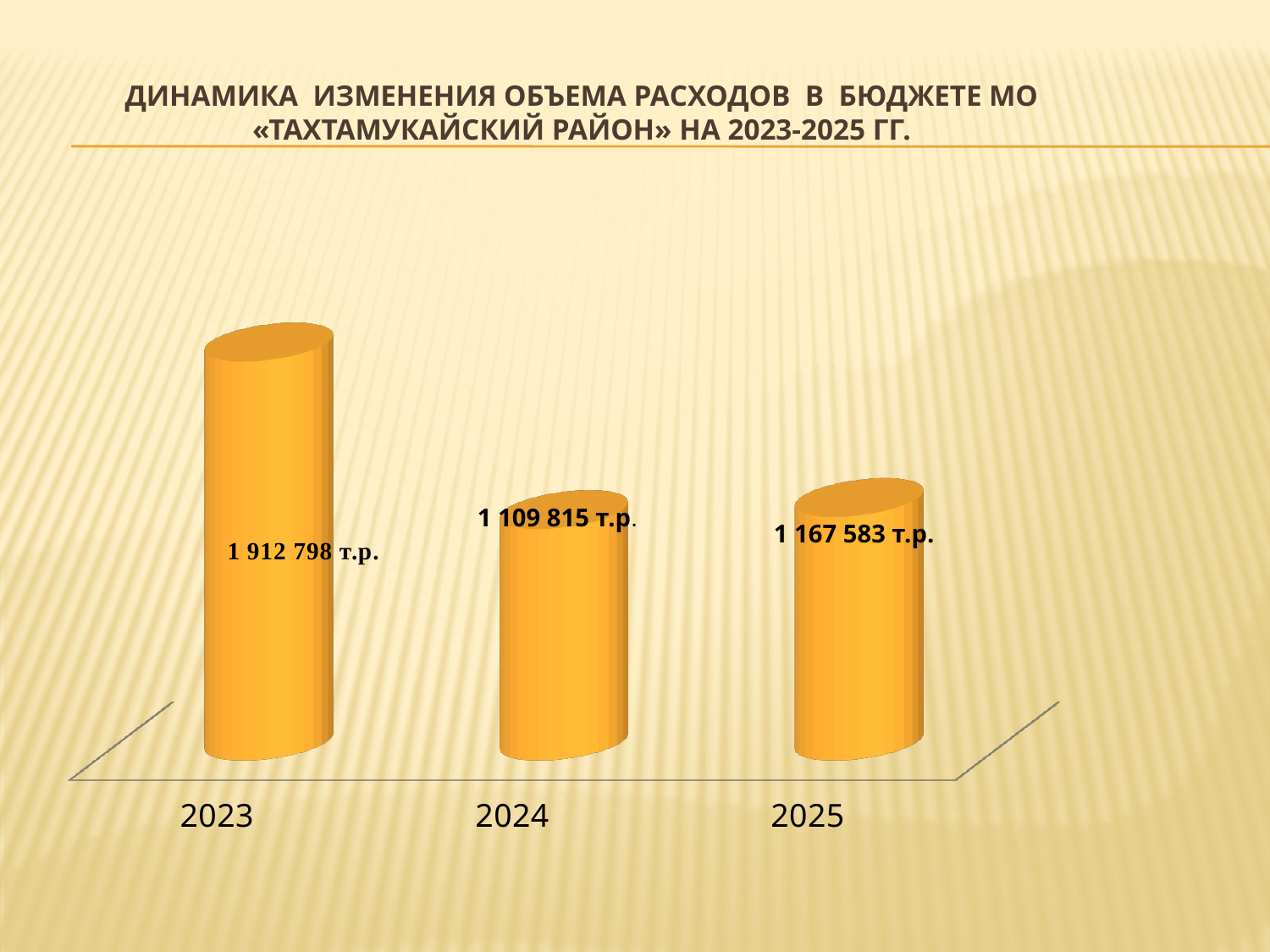
Which year has the highest value? 2023 How many years are shown on the chart? 3 Which year has the lowest value? 2024 What is the value shown for 2023? 1 912 798 т.р. What is the value shown for 2024? 1 109 815 т.р. What kind of chart is shown on the slide? Bar chart What is the title of the chart? Динамика изменения объема расходов в бюджете МО «Тахтамукайский район» на 2023-2025 гг. Does the value fall or rise from 2023 to 2024? Fall What is the value shown for 2025? 1 167 583 т.р. Which is larger, the value for 2024 or the value for 2025? 2025 What is the difference between the values for 2023 and 2024? 802 983 т.р. What is the difference between the values for 2025 and 2024? 57 768 т.р.